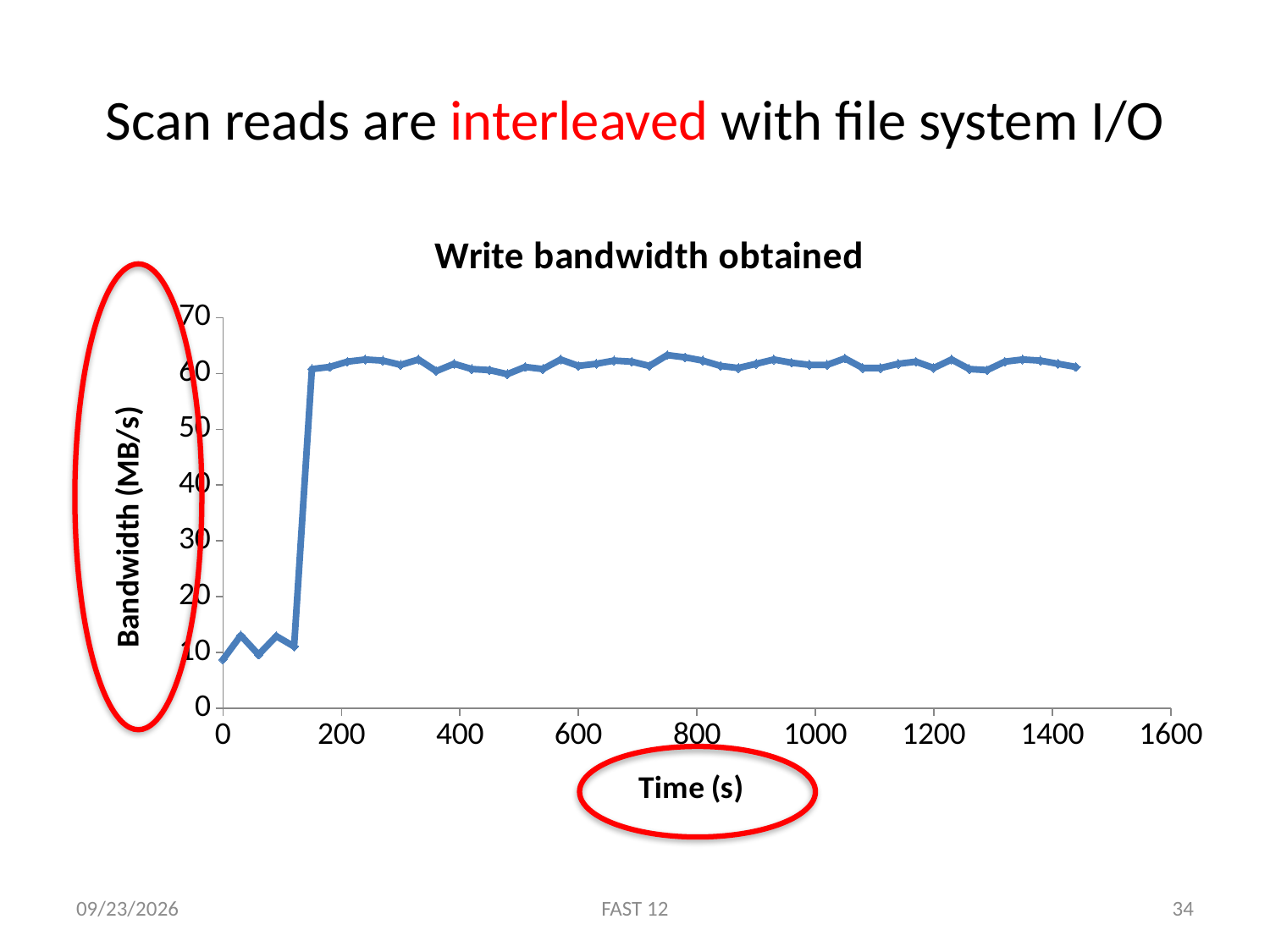
Which has the higher write bandwidth: time 50 s or time 200 s? 200 s Is the write bandwidth at time 1400 s greater or less than 40 MB/s? greater Is the write bandwidth at time 0 s greater or less than 20 MB/s? less Is the write bandwidth at time 400 s greater or less than 50 MB/s? greater What is the label of the y axis of the chart? Bandwidth (MB/s) What is the highest value shown on the x axis (Time) of the chart? 1600 Does the write bandwidth rise or fall between time 100 s and time 200 s? rise What is the title of the chart? Write bandwidth obtained Overall, does the write bandwidth rise or fall from the start of the chart to the end? rise What kind of chart is shown on the slide? line chart